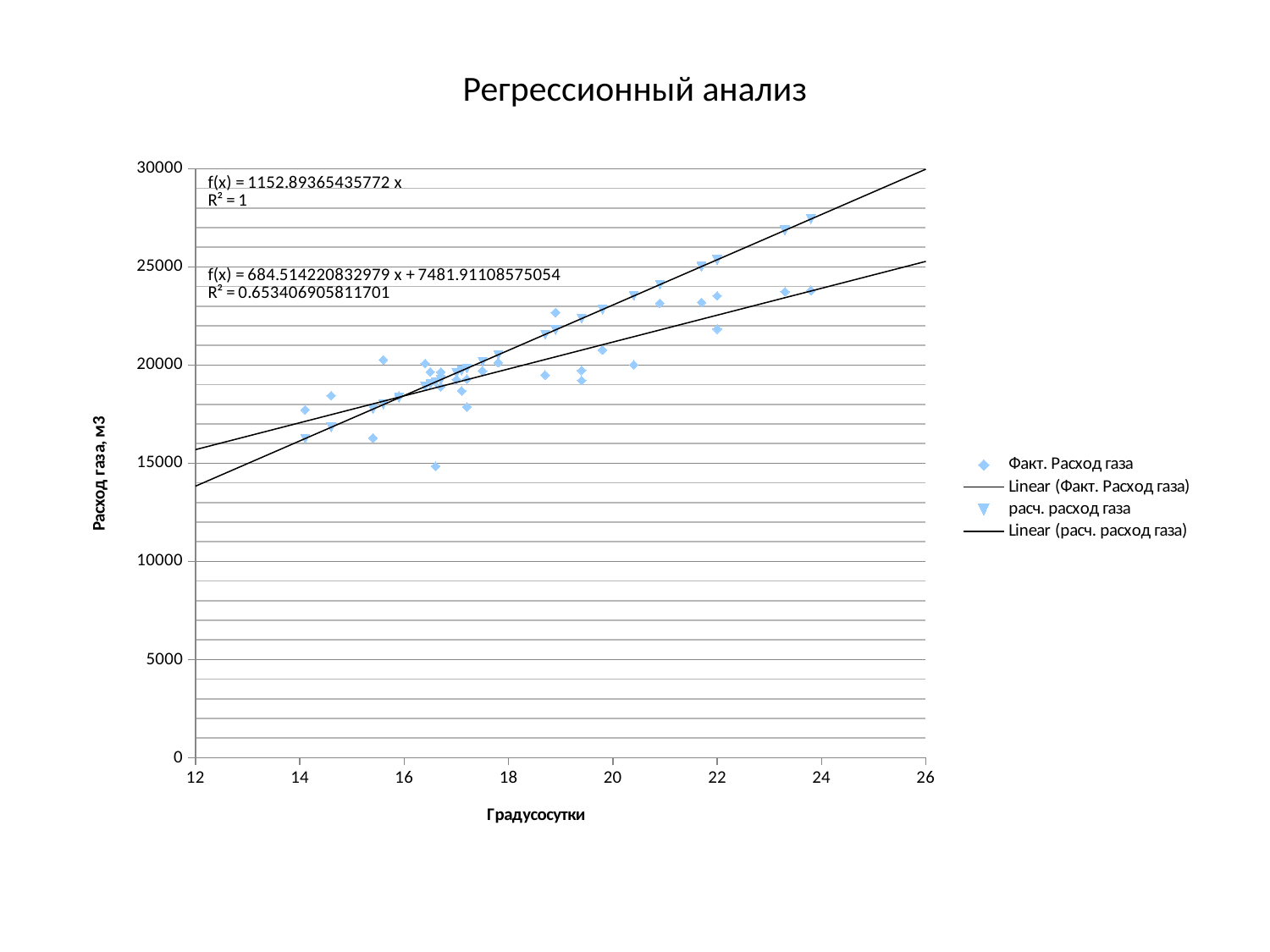
What is the title of the x axis? Градусосутки What is the intercept printed in the second trendline equation? 7481.91108575054 What is the maximum value shown on the y axis? 30000 What is the slope printed in the trendline equation that has no intercept term? 1152.89365435772 What is the R² value printed for the trendline f(x) = 684.514220832979 x + 7481.91108575054? 0.653406905811701 Do the plotted values generally rise or fall as Градусосутки increases along the x axis? rise What kind of chart is shown on the slide? scatter chart What is the title of the chart? Регрессионный анализ Is the highest plotted point on the chart greater or less than 25000? greater How many entries does the chart legend list? 4 What is the R² value printed for the trendline f(x) = 1152.89365435772 x? R² = 1 Is the lowest plotted point on the chart greater or less than 20000? less